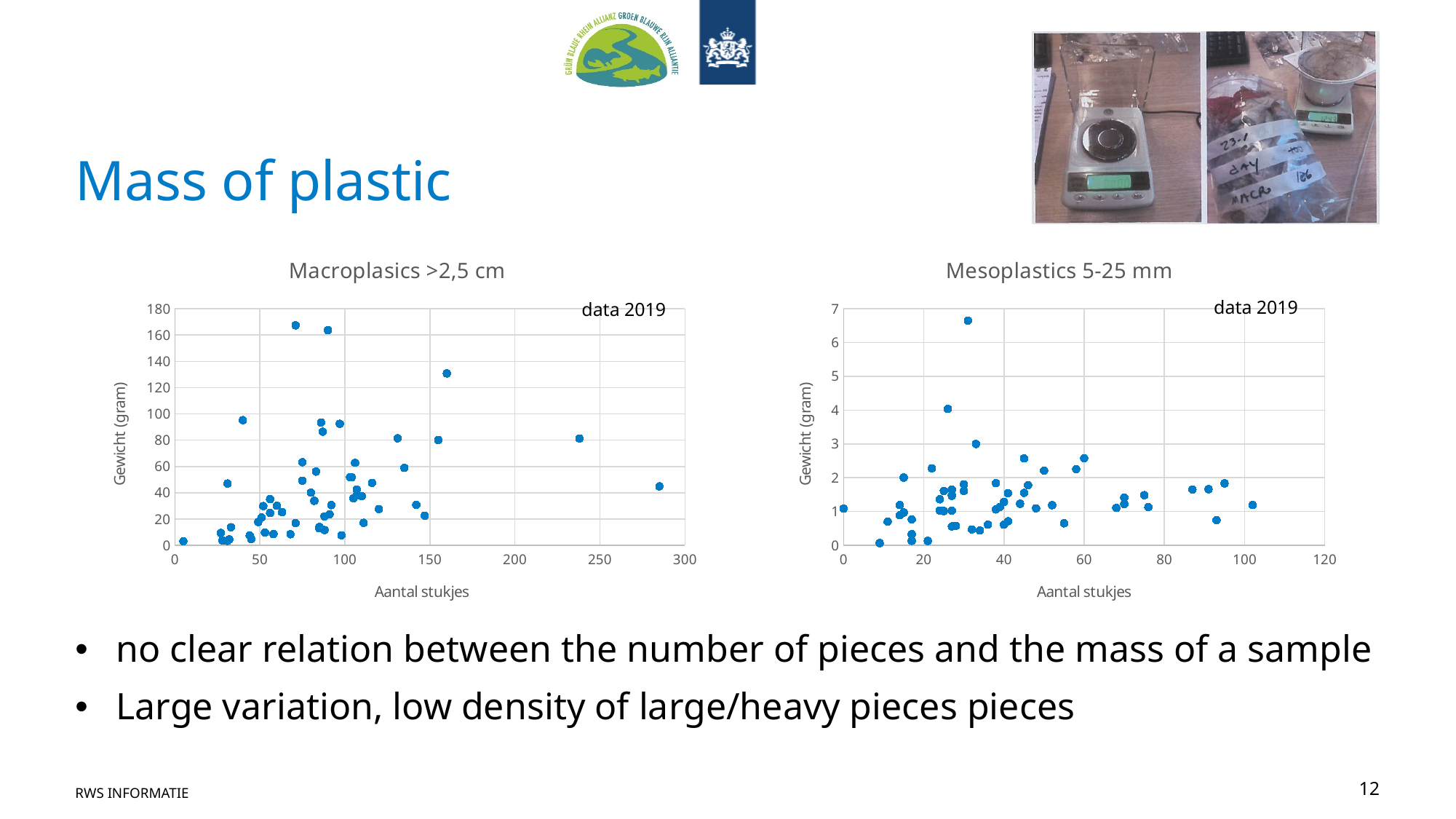
What is the y-axis label of the 'Macroplasics >2,5 cm' chart? Gewicht (gram) What kind of chart is the 'Mesoplastics 5-25 mm' chart on the right? scatter chart In the 'Mesoplastics 5-25 mm' chart, is the weight of the highest point greater or less than 6? greater How many charts are shown on the slide? 2 In the 'Macroplasics >2,5 cm' chart, is the weight of the rightmost point (near 285 pieces) greater or less than 60? less In the 'Mesoplastics 5-25 mm' chart, is the weight of the rightmost point (near 100 pieces) greater or less than 2? less What kind of chart is the 'Macroplasics >2,5 cm' chart on the left? scatter chart What is the title of the chart on the right of the slide? Mesoplastics 5-25 mm